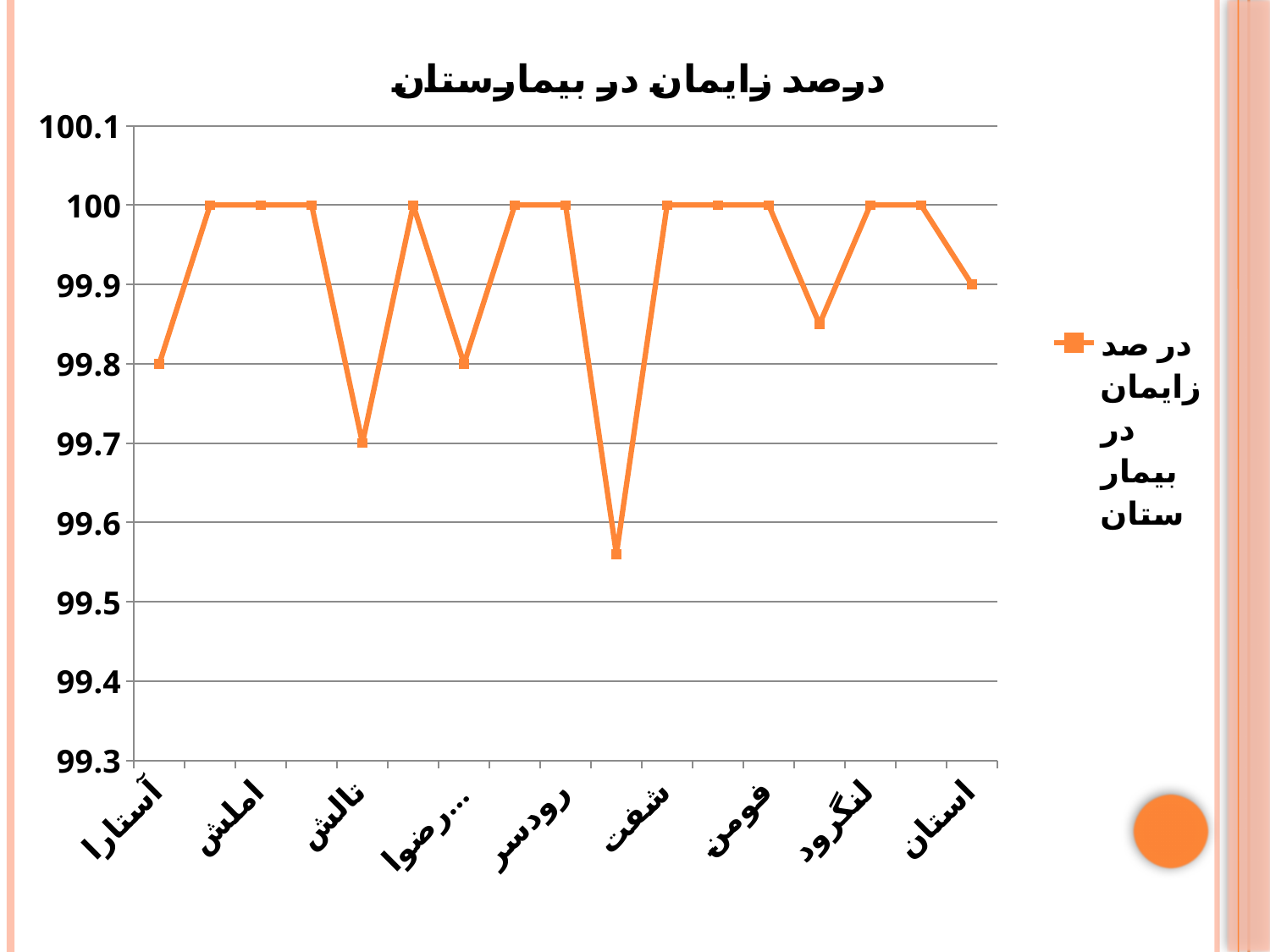
Is the value for لنگرود greater or less than 99.9? greater What is the value for رودسر? 100 Is the value for شفت greater or less than 99.9? greater How many series does the legend list? 1 What is the value for تالش? 99.7 What is the value for آستارا? 99.8 What is the value for املش? 100 How many data points are plotted on the line? 17 What kind of chart is shown on the slide? line chart What is the value for استان? 99.9 Which is larger, the value for آستارا or the value for تالش? آستارا What is the difference between the values for آستارا and تالش? 0.1